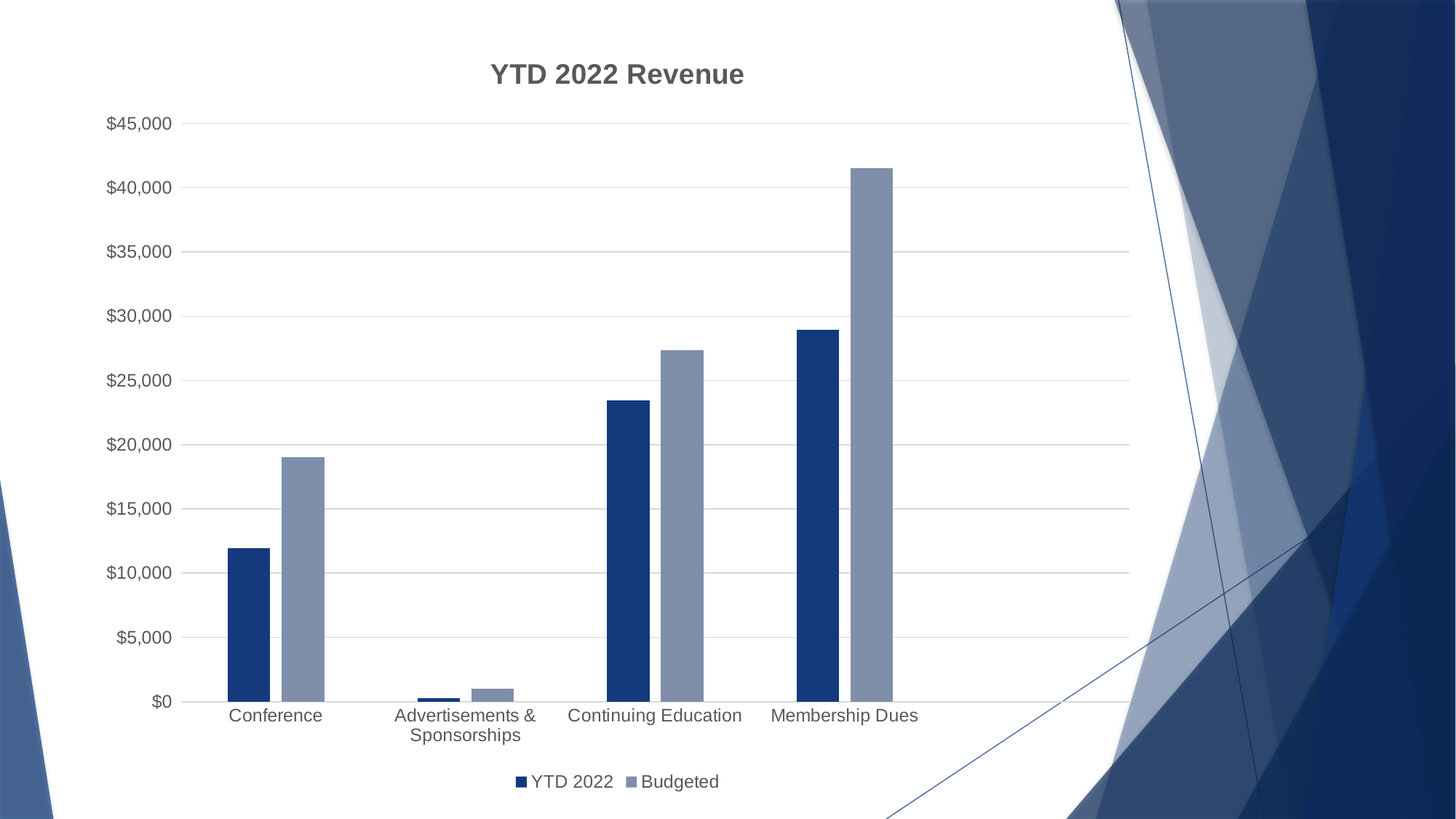
Which category has the highest Budgeted value? Membership Dues How many series does the legend list? 2 Is the YTD 2022 value for Conference greater or less than $10,000? greater Is the Budgeted value for Membership Dues greater or less than $40,000? greater Is the YTD 2022 value for Membership Dues greater or less than $30,000? less For Conference, which is larger: the YTD 2022 value or the Budgeted value? Budgeted What kind of chart is shown on the slide? bar chart Which series is shown in dark blue in the legend? YTD 2022 What is the title of the chart? YTD 2022 Revenue How many categories are shown on the x axis? 4 Which category has the lowest YTD 2022 value? Advertisements & Sponsorships